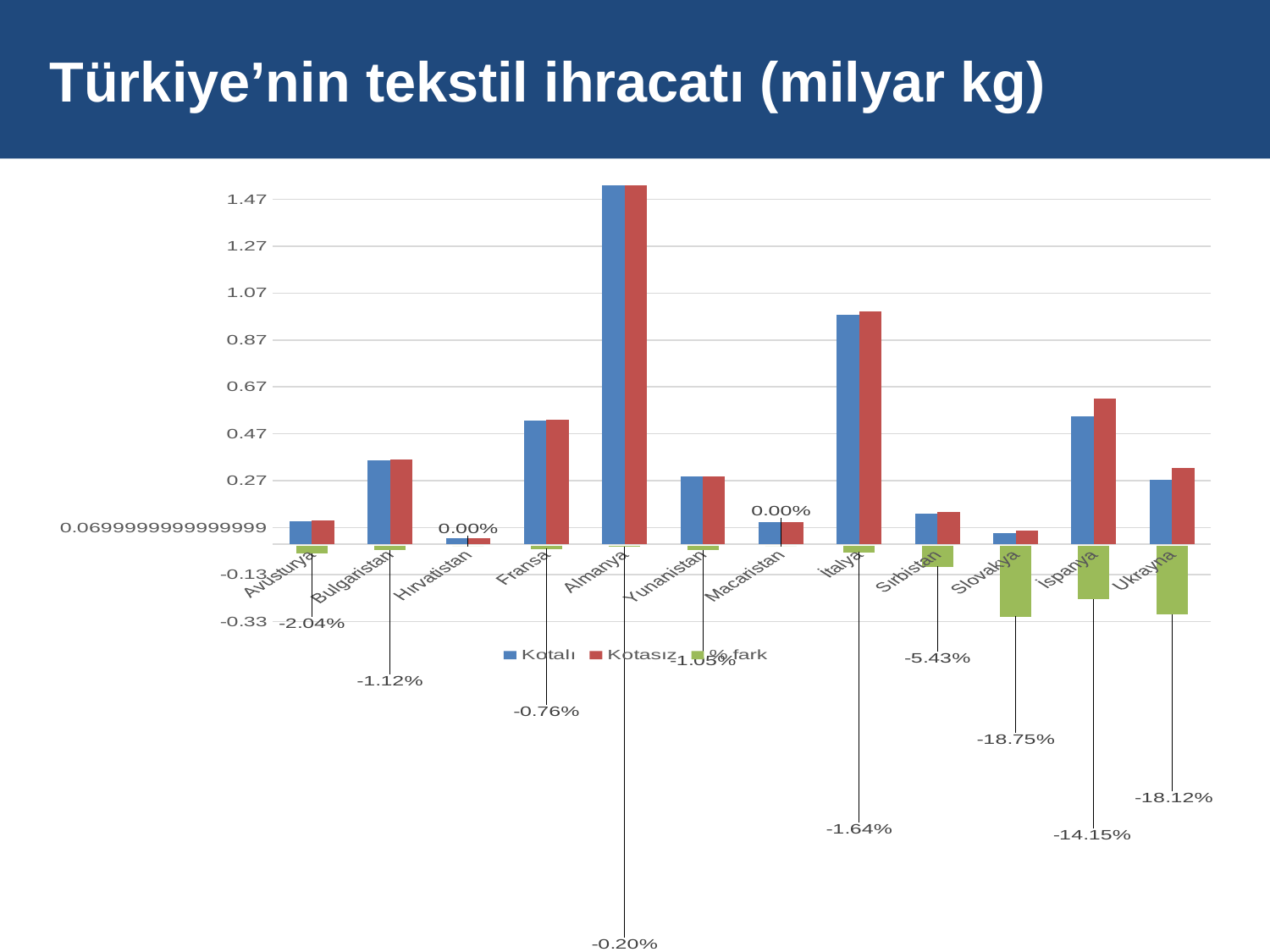
How many series does the legend list? 3 Which country has the highest Kotalı value? Almanya What is the % fark value for Avusturya? -2.04% What type of chart is shown on the slide? bar chart What is the % fark value for Slovakya? -18.75% What is the difference between the % fark values for Slovakya and Ukrayna? 0.63 percentage points What is the % fark value for Sırbistan? -5.43% Is the Kotalı value for Fransa greater or less than 0.67? less Which country has the lowest % fark value? Slovakya Which is larger, the % fark value for Avusturya or for Sırbistan? Avusturya How many countries are shown on the x axis? 12 Is the Kotasız value for İtalya greater or less than 0.87? greater